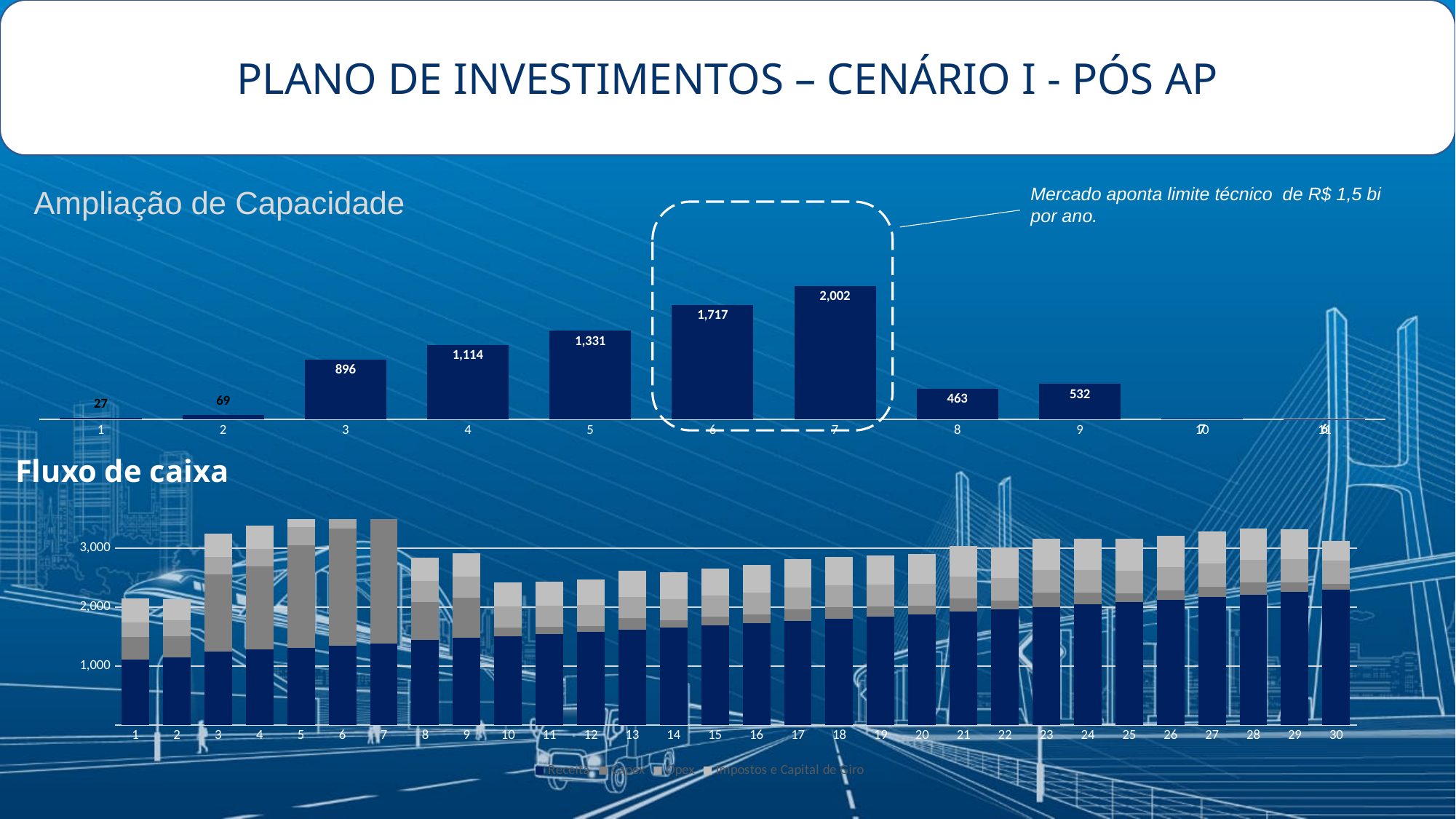
In the Ampliação de Capacidade chart, what is the value for category 3? 896 In the Ampliação de Capacidade chart, which category has the highest value? 7 In the Fluxo de caixa chart, how many categories are shown on the x axis? 30 In the Ampliação de Capacidade chart, what is the value for category 7? 2,002 In the Ampliação de Capacidade chart, what is the difference between the values for categories 7 and 6? 285 In the Fluxo de caixa chart, is the total of the stacked bar for category 1 greater or less than 3,000? less In the Ampliação de Capacidade chart, what is the difference between the values for categories 5 and 4? 217 In the Fluxo de caixa chart, is the dark blue (bottom) segment for category 30 greater or less than 2,000? greater What kind of chart is the Fluxo de caixa chart? stacked bar chart In the Ampliação de Capacidade chart, which category has the lowest value? 11 What kind of chart is the Ampliação de Capacidade chart? bar chart In the Ampliação de Capacidade chart, which is larger, the value for category 8 or category 9? 9